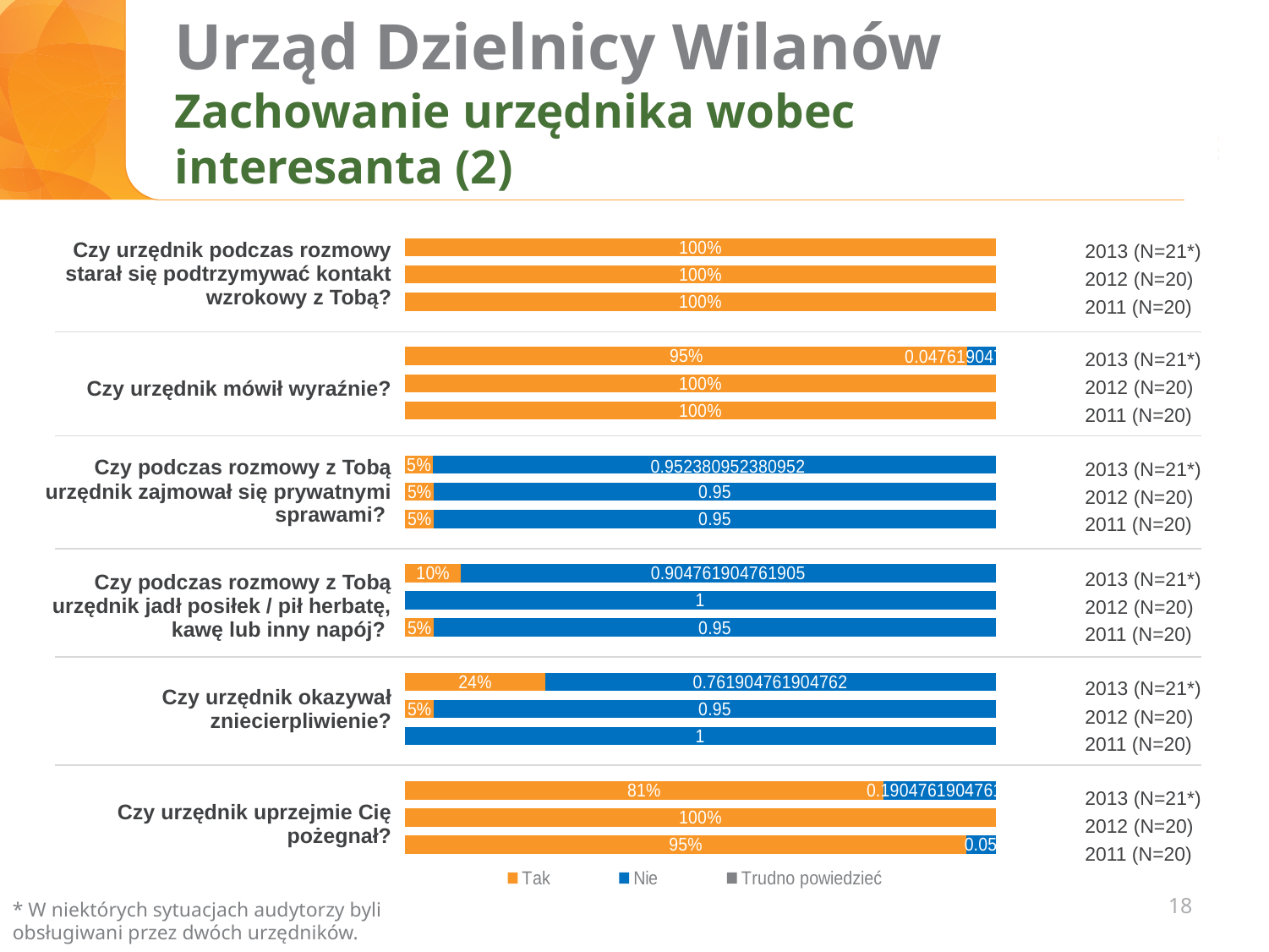
What is the 'Tak' value for 'Czy podczas rozmowy z Tobą urzędnik jadł posiłek / pił herbatę, kawę lub inny napój?' in 2013 (N=21*)? 10% What is the 'Tak' value for 'Czy urzędnik okazywał zniecierpliwienie?' in 2013 (N=21*)? 24% What kind of chart is shown on the slide? Stacked horizontal bar chart What are the entries in the chart legend? Tak, Nie, Trudno powiedzieć How many series does the chart legend list? 3 For 2013 (N=21*), which has the larger 'Tak' value: 'Czy urzędnik okazywał zniecierpliwienie?' or 'Czy urzędnik uprzejmie Cię pożegnał?' Czy urzędnik uprzejmie Cię pożegnał? By how many percentage points did the 'Tak' value for 'Czy urzędnik uprzejmie Cię pożegnał?' fall from 2012 (N=20) to 2013 (N=21*)? 19 percentage points What is the 'Tak' value for 'Czy urzędnik uprzejmie Cię pożegnał?' in 2013 (N=21*)? 81% How many years (bars) are shown for each question in the chart? 3 What is the sample size shown for 2013 in the chart? N=21* What is the 'Tak' value for 'Czy urzędnik mówił wyraźnie?' in 2013 (N=21*)? 95% What is the 'Nie' data label for 'Czy urzędnik okazywał zniecierpliwienie?' in 2013 (N=21*)? 0.761904761904762